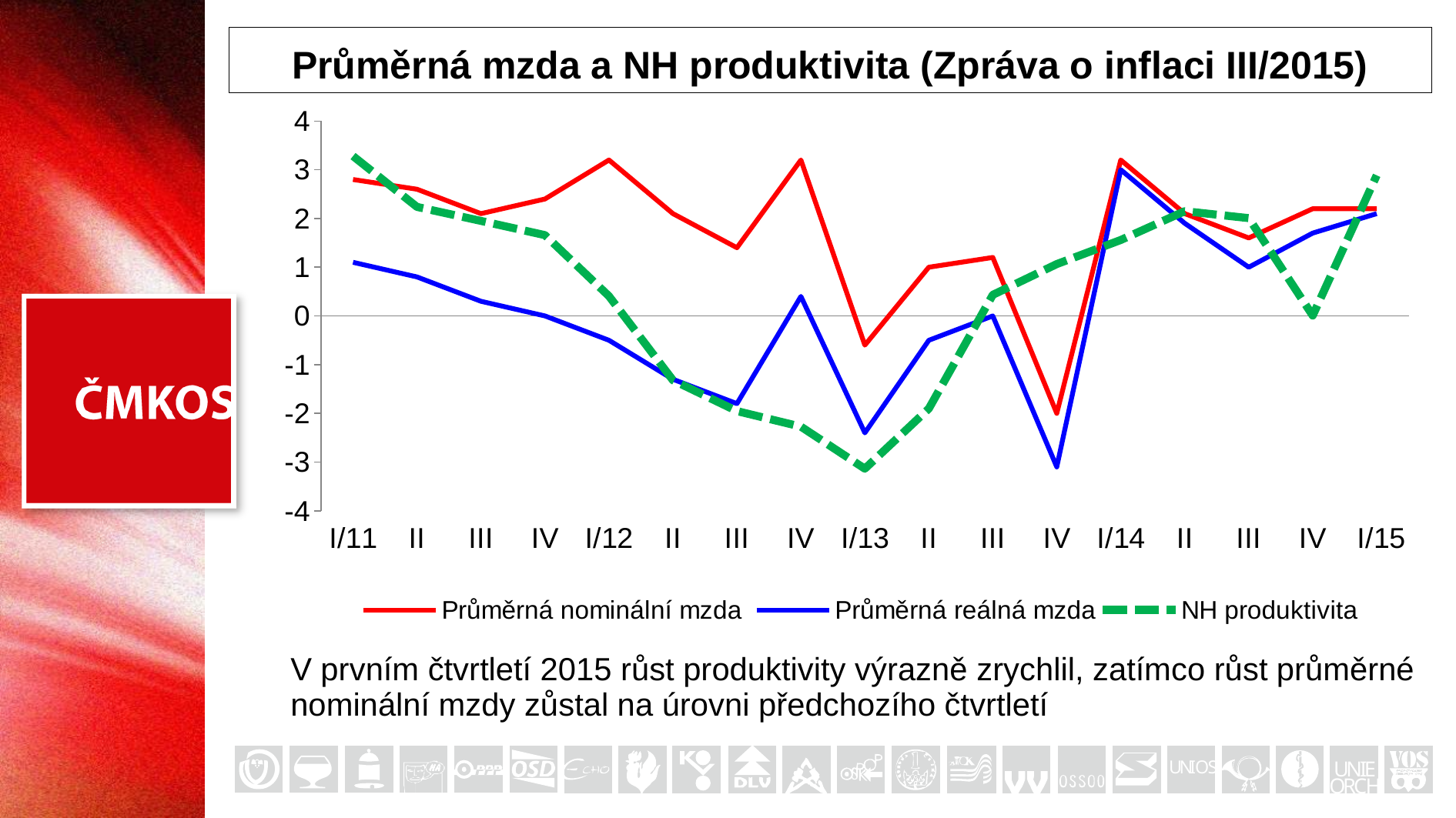
At I/13, which is larger: Průměrná nominální mzda or Průměrná reálná mzda? Průměrná nominální mzda Is the value of Průměrná reálná mzda at IV (2013, the quarter before I/14) greater or less than -2? less What kind of chart is shown on the slide? line chart At which quarter does Průměrná reálná mzda reach its lowest value? IV (2013) How many series does the legend list? 3 Does Průměrná reálná mzda rise or fall from I/11 to IV (2012)? fall Is the value of Průměrná nominální mzda at I/11 greater or less than 2? greater Is the value of NH produktivita at I/13 greater or less than -2? less At which quarter does Průměrná reálná mzda reach its highest value? I/14 Which series is drawn with a dashed green line? NH produktivita At which quarter does NH produktivita reach its lowest value? I/13 How many quarters are plotted along the x axis? 17